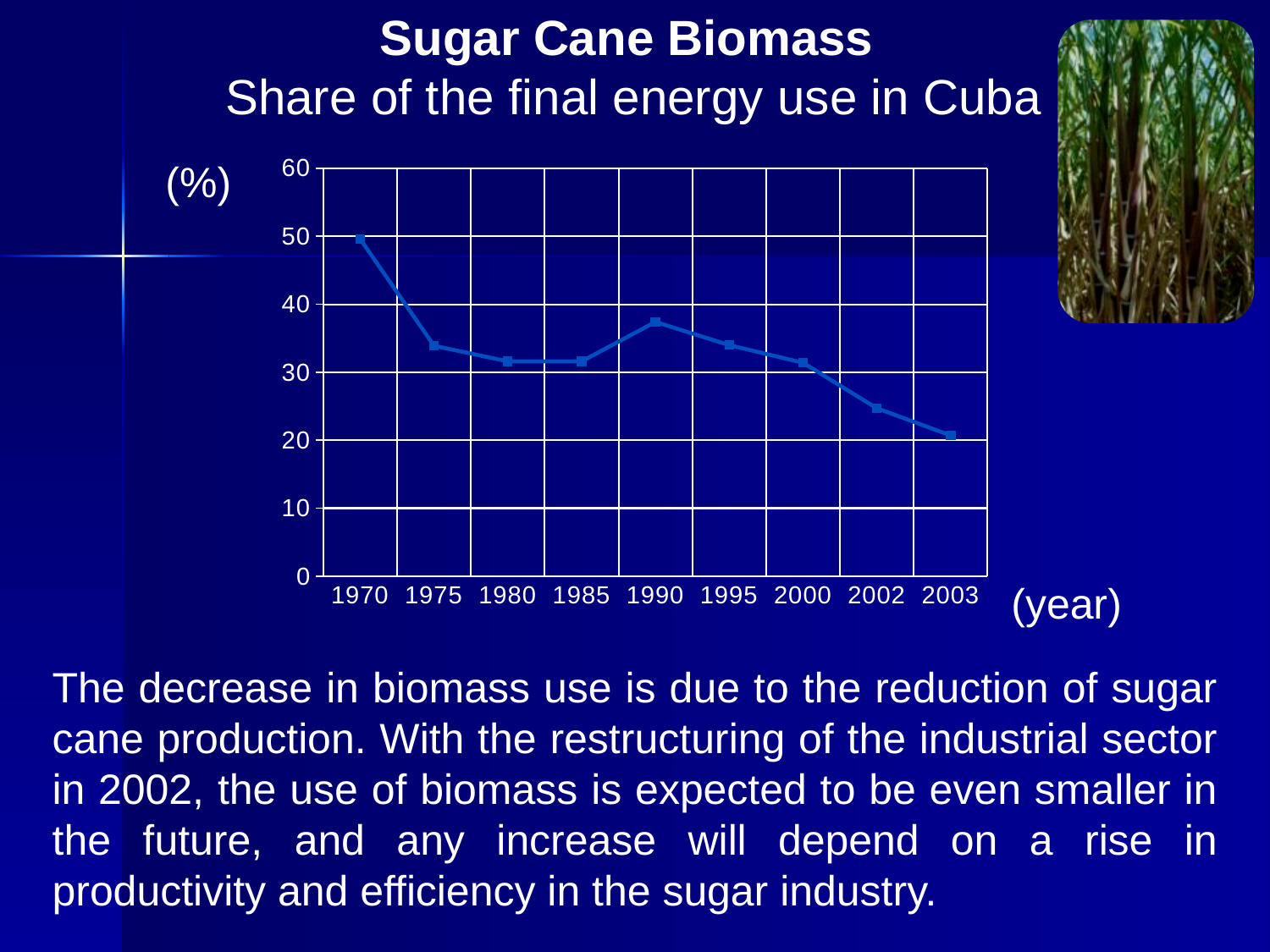
How many years are plotted on the x axis of the chart? 9 What unit is shown on the y axis of the chart? (%) Overall, do the values rise or fall from 1970 to 2003? fall Which year has a larger value, 1990 or 2002? 1990 Is the value for 2003 greater or less than 30? less Is the value for 2002 greater or less than 30? less What kind of chart is shown on the slide? line chart Is the value for 1970 greater or less than 40? greater Which year has the highest share of final energy use from sugar cane biomass? 1970 Which year has a larger value, 1970 or 2003? 1970 Which year has the lowest share of final energy use from sugar cane biomass? 2003